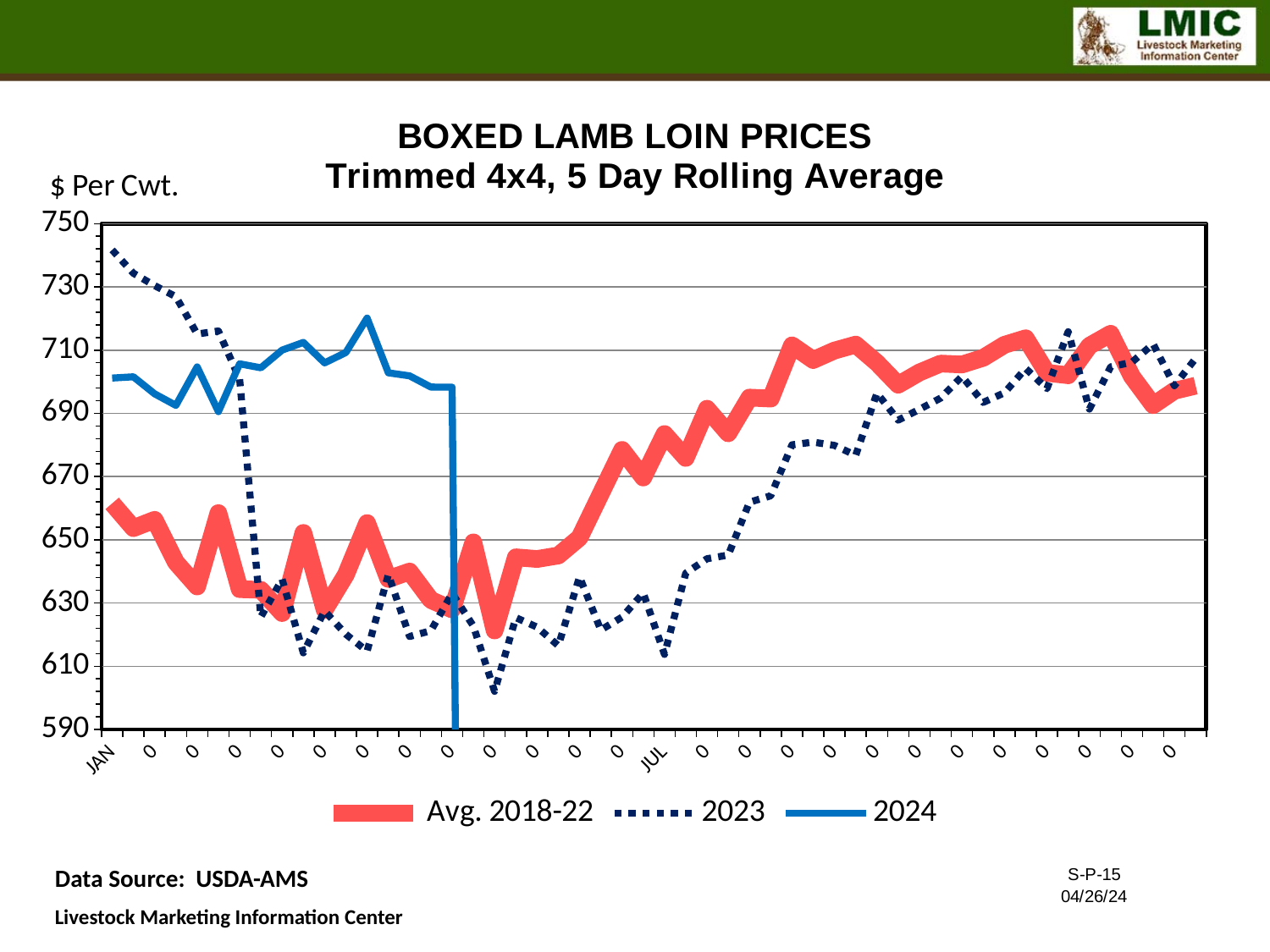
What are the three series listed in the legend? Avg. 2018-22, 2023, 2024 At JUL, which series has the higher value: Avg. 2018-22 or 2023? Avg. 2018-22 How many series does the legend list? 3 Is the value of the 2024 series at JAN greater or less than 690? greater Which series reaches the highest value anywhere on the chart? 2023 At JAN, which series has the higher value: 2023 or 2024? 2023 Is the value of the 2023 series at JAN greater or less than 730? greater Is the value of the Avg. 2018-22 series at JAN greater or less than 650? greater What unit is shown on the vertical axis of the chart? $ Per Cwt. What kind of chart is shown on the slide? line chart Does the 2023 series end the year higher or lower than it starts in JAN? lower